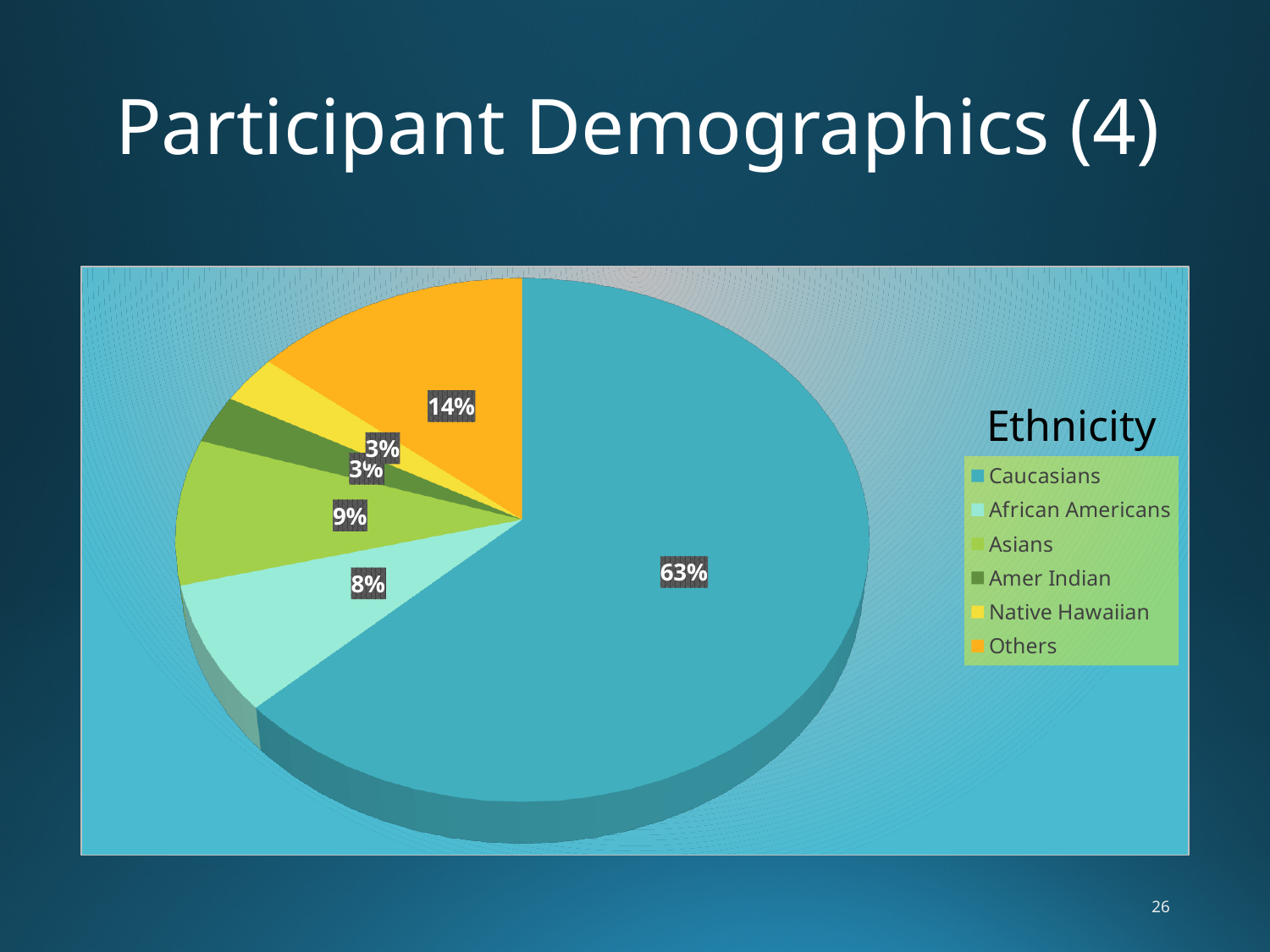
What share of the pie is Asians? 9% What share of the pie is Native Hawaiian? 3% What kind of chart is shown on the slide? pie chart Which category has the largest slice of the pie? Caucasians What is the title of the chart? Ethnicity What share of the pie is African Americans? 8% How many categories does the legend list? 6 Which colour represents Others in the pie chart? orange What is the difference between the share for Caucasians and the share for Others? 49% Which is larger, the share for Asians or the share for African Americans? Asians